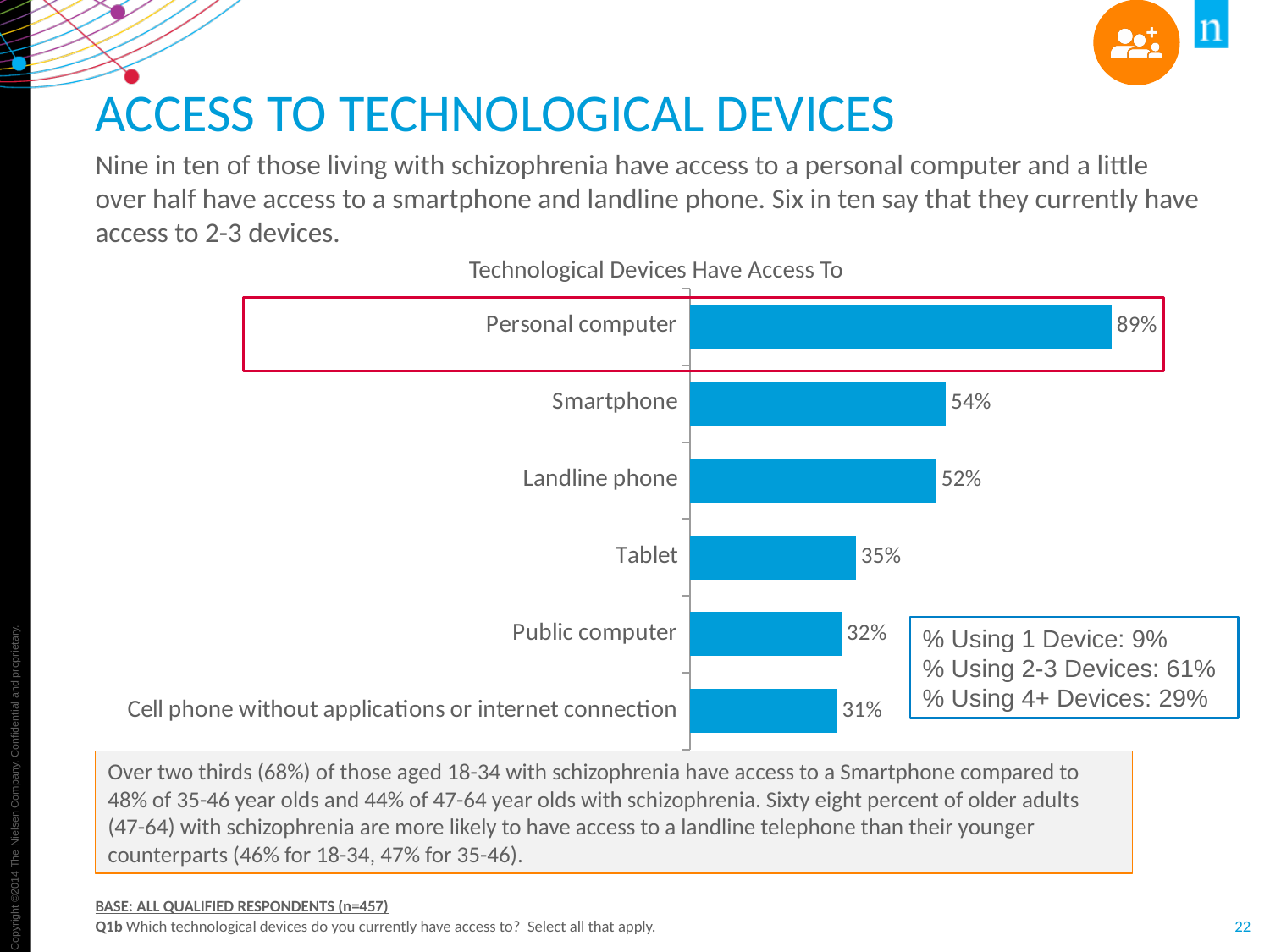
What percentage of respondents have access to a personal computer? 89% Which device has the lowest percentage of respondents with access? Cell phone without applications or internet connection What percentage of respondents have access to a cell phone without applications or internet connection? 31% What percentage of respondents have access to a tablet? 35% What is the title of the chart? Technological Devices Have Access To What is the difference in percentage points between access to a personal computer and access to a smartphone? 35 How many device categories are shown in the chart? 6 What type of chart is used to show the technological devices data? Bar chart Which has a higher percentage: Smartphone or Landline phone? Smartphone Which has a higher percentage: Tablet or Public computer? Tablet What is the difference in percentage points between access to a landline phone and access to a tablet? 17 Which device has the highest percentage of respondents with access? Personal computer